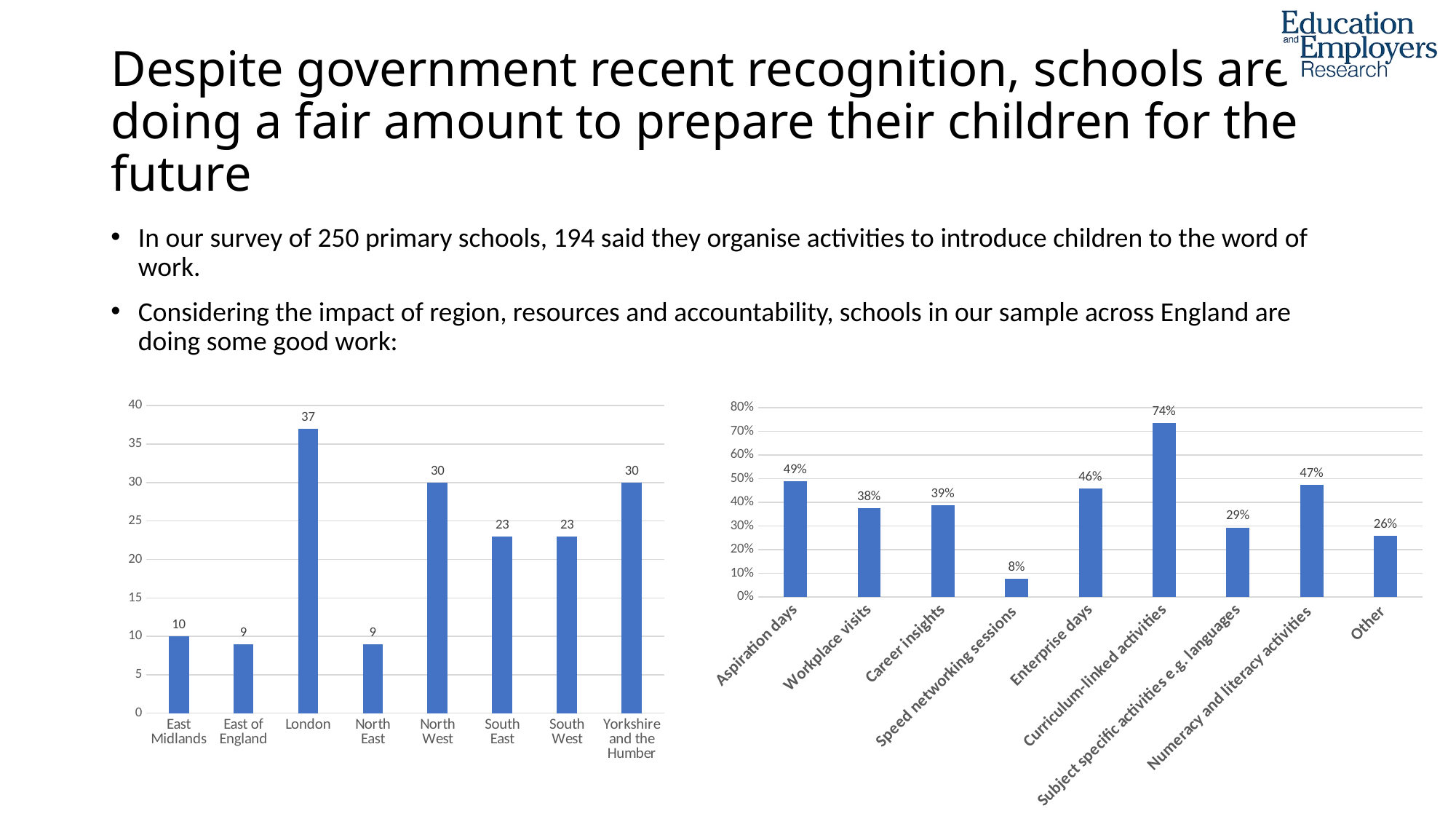
In the left chart, what is the value for South East? 23 In the right chart, which is larger: Workplace visits or Enterprise days? Enterprise days In the left chart, how many regions are shown? 8 In the right chart, what is the difference between Aspiration days and Other? 23% In the right chart, what is the value for Curriculum-linked activities? 74% What type of chart is the right chart? Bar chart In the right chart, how many activity categories are shown? 9 In the left chart, which region has the lowest value? East of England and North East (both 9) In the left chart, what is the value for London? 37 In the left chart, what is the difference between London and North West? 7 In the right chart, which activity has the lowest value? Speed networking sessions In the left chart, which region has the highest value? London